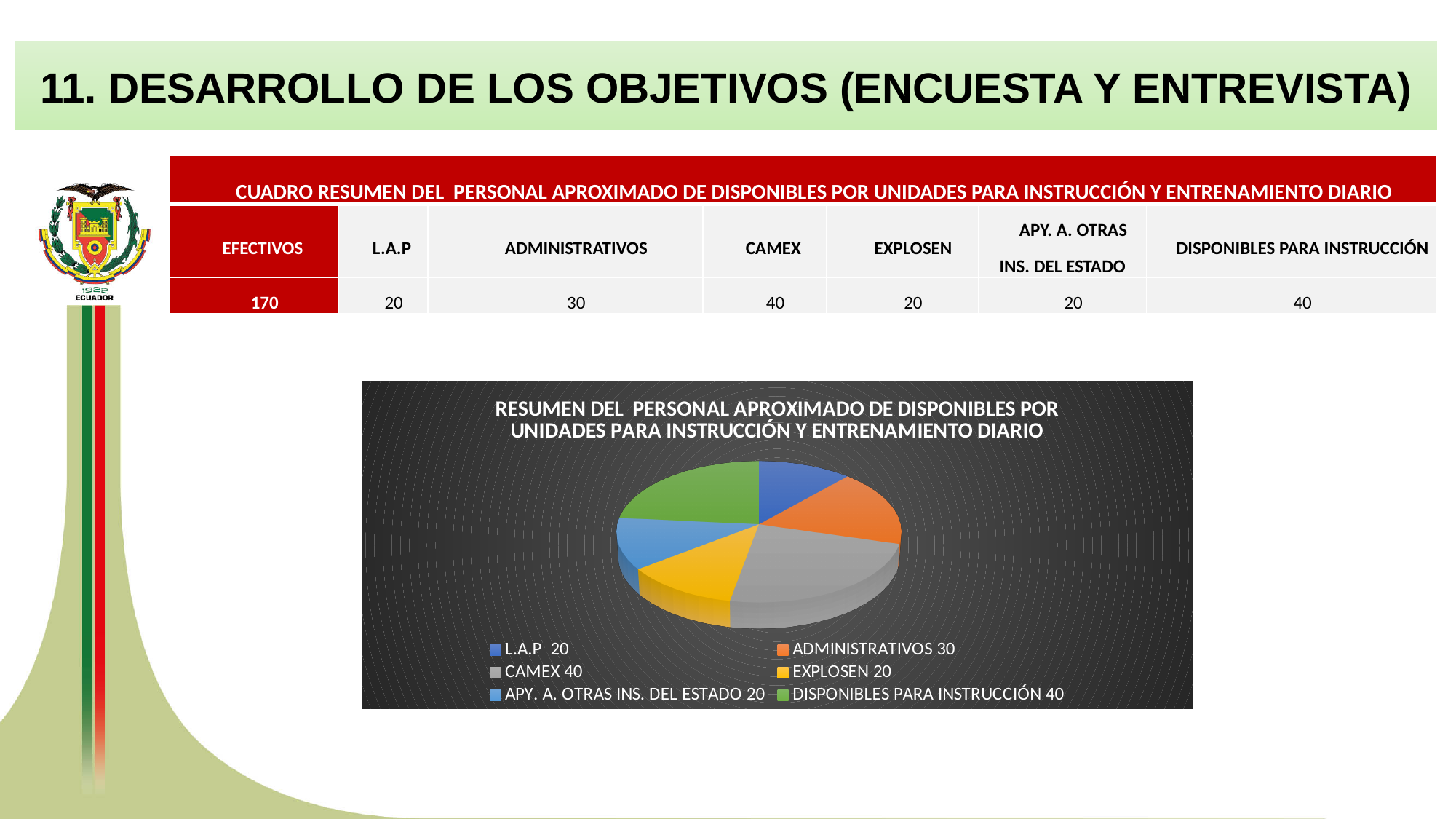
What is the value for L.A.P in the pie chart? 20 What is the value for DISPONIBLES PARA INSTRUCCIÓN in the pie chart? 40 What is the value for CAMEX in the pie chart? 40 What is the difference between the values for DISPONIBLES PARA INSTRUCCIÓN and ADMINISTRATIVOS in the pie chart? 10 What is the value for APY. A. OTRAS INS. DEL ESTADO in the pie chart? 20 What colour is the CAMEX slice in the pie chart? grey What is the difference between the values for CAMEX and EXPLOSEN in the pie chart? 20 What kind of chart is shown on the slide? pie chart How many slices does the pie chart have? 6 What is the value for ADMINISTRATIVOS in the pie chart? 30 Which is larger in the pie chart, ADMINISTRATIVOS or L.A.P? ADMINISTRATIVOS What is the value for EXPLOSEN in the pie chart? 20